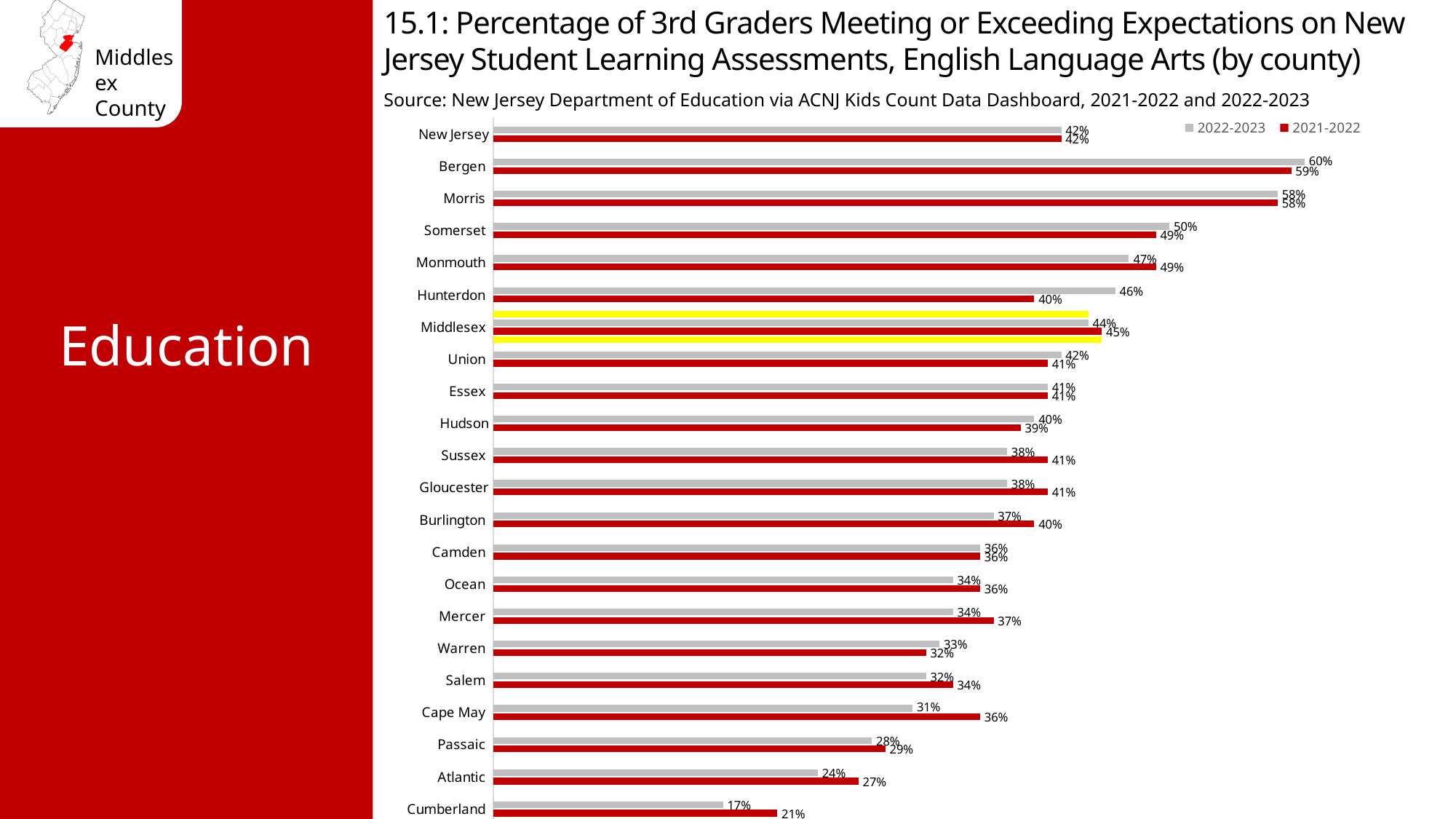
What is the 2022-2023 value for Middlesex? 44% What kind of chart is shown on the slide? Bar chart What is the 2022-2023 value for Cape May? 31% What is the difference between the 2022-2023 and 2021-2022 values for Hunterdon? 6% Which county has the lowest 2021-2022 value? Cumberland Which county has the highest 2022-2023 value? Bergen How many counties or regions are listed on the chart? 22 Which county is highlighted in yellow on the chart? Middlesex Which is larger for Monmouth, the 2022-2023 value or the 2021-2022 value? 2021-2022 What is the 2021-2022 value for Hunterdon? 40% How many series does the legend list? 2 What is the difference between the 2021-2022 values for Bergen and Cumberland? 38%